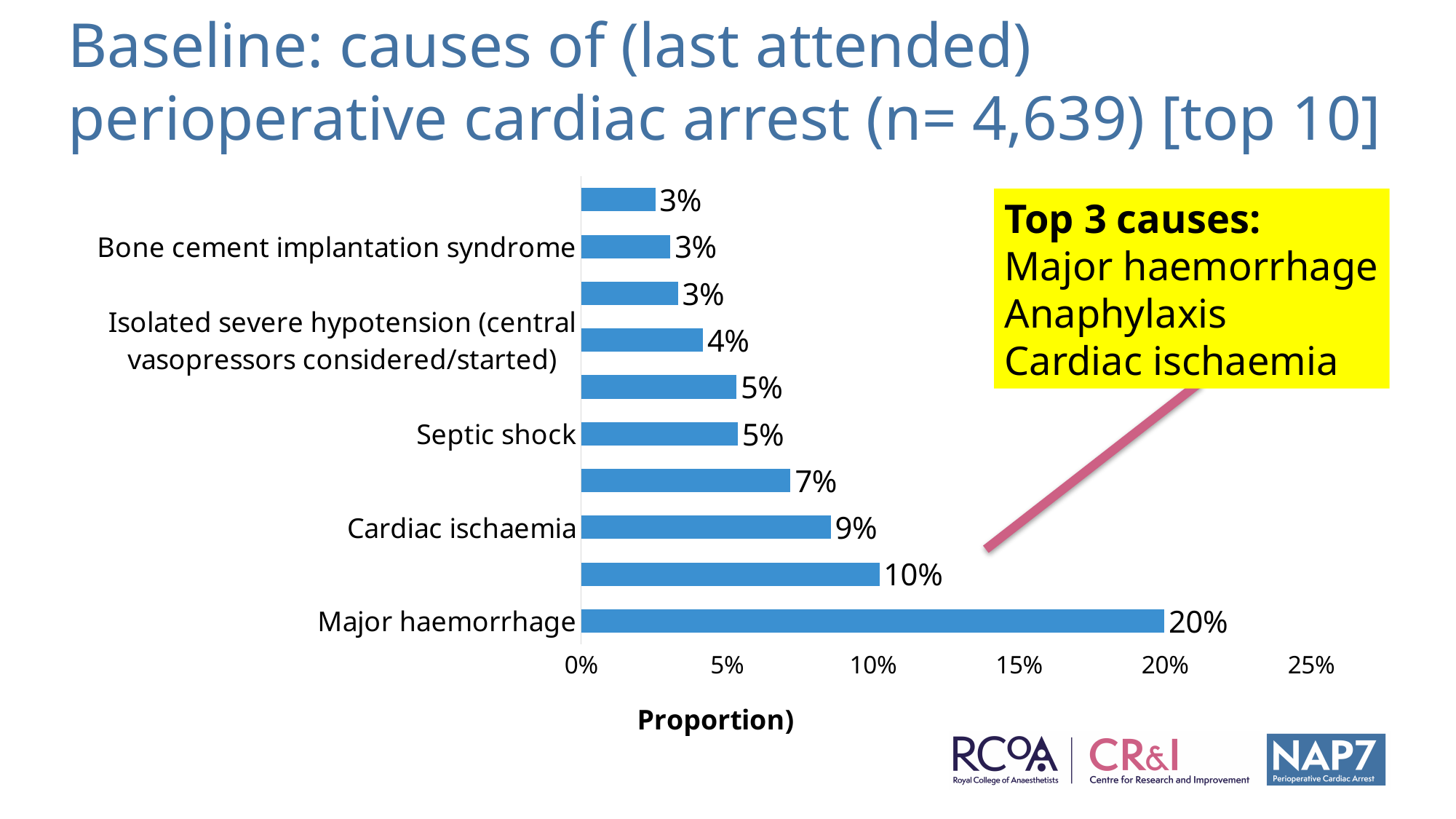
What is the value for Isolated severe hypotension (central vasopressors considered/started)? 4% Is the value for Major haemorrhage greater or less than 15%? greater What is the value for Major haemorrhage? 20% Which cause has the highest proportion? Major haemorrhage What is the value for Cardiac ischaemia? 9% How many bars are plotted in the chart? 10 What is the difference between the values for Major haemorrhage and Cardiac ischaemia? 11% What is the label on the horizontal axis of the chart? Proportion) Which is larger, the value for Cardiac ischaemia or the value for Septic shock? Cardiac ischaemia What kind of chart is shown on the slide? Bar chart What is the value for Bone cement implantation syndrome? 3% What is the value for Septic shock? 5%